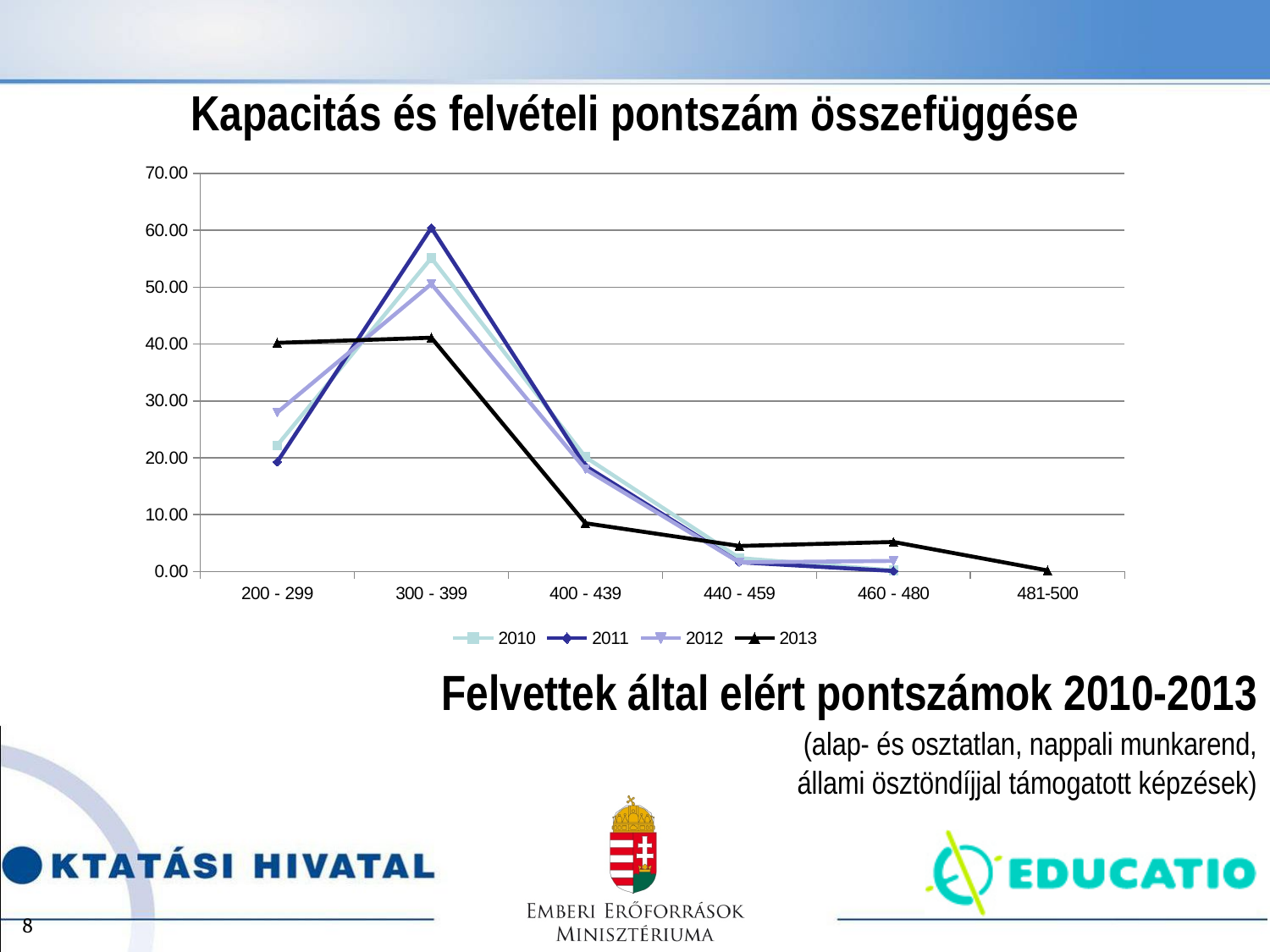
Does the 2011 series rise or fall from the 300 - 399 category to the 460 - 480 category? fall For the 2013 series, which category has the lowest value? 481-500 What kind of chart is shown on the slide? line chart How many score-range categories are shown on the x axis? 6 In the 200 - 299 category, which is larger: the value for 2013 or the value for 2011? 2013 How many series does the legend list? 4 Is the value for 2011 in the 300 - 399 category greater or less than 50.00? greater Is the value for 2011 in the 200 - 299 category greater or less than 30.00? less For the 2010 series, which category has the highest value? 300 - 399 Is the value for 2013 in the 400 - 439 category greater or less than 10.00? less Which series has the highest value in the 300 - 399 category? 2011 What is the title of the chart? Kapacitás és felvételi pontszám összefüggése